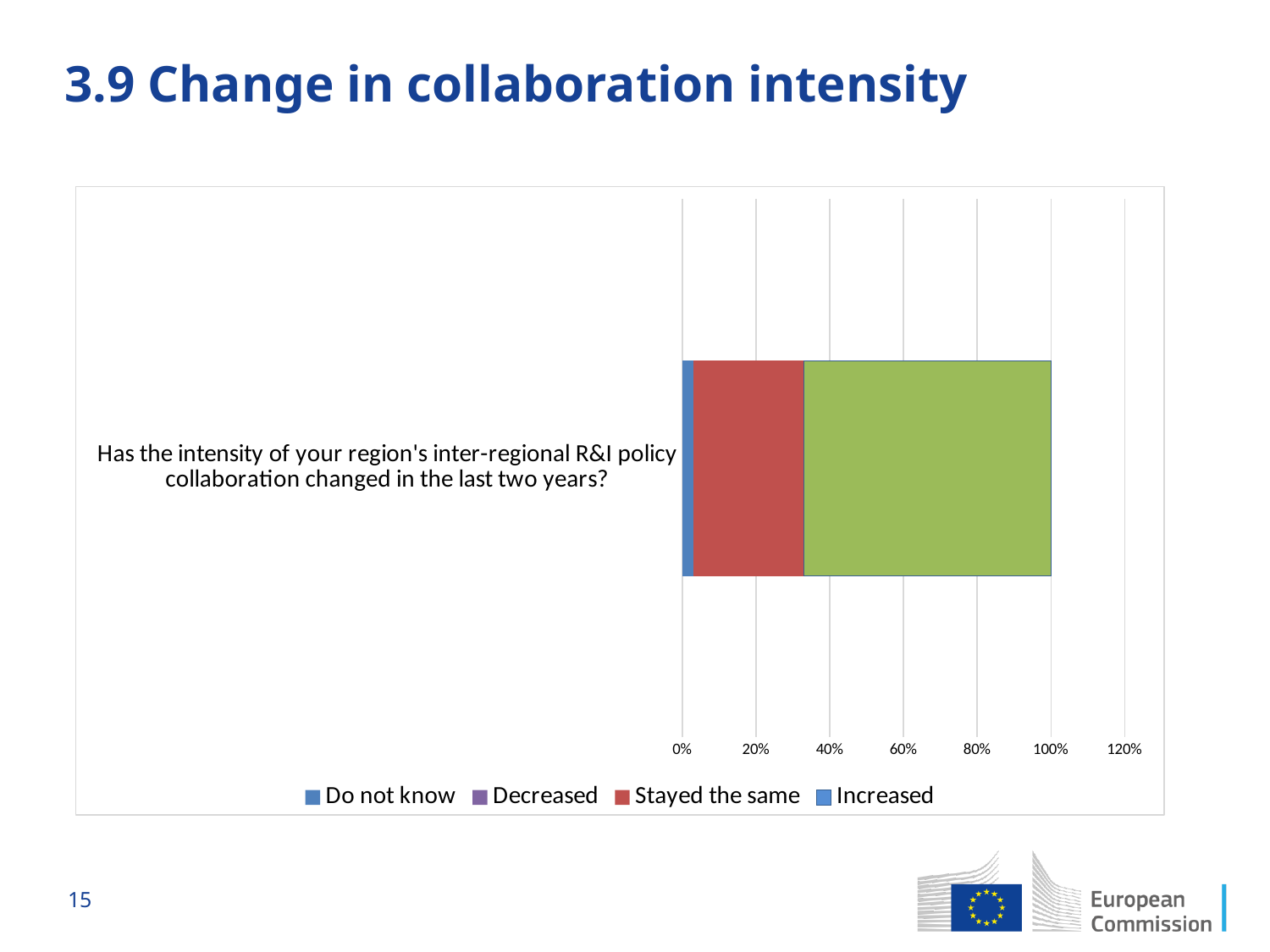
What kind of chart is shown on the slide? bar chart Is the value for 'Stayed the same' greater or less than 40%? less Which series is listed first in the legend? Do not know What is the category label of the single bar in the chart? Has the intensity of your region's inter-regional R&I policy collaboration changed in the last two years? What is the highest value shown on the x axis? 120% What is the total of the stacked bar, as read from the x axis? 100% How many categories (bars) are plotted in the chart? 1 How many series does the legend list? 4 Is the value for 'Do not know' greater or less than 20%? less